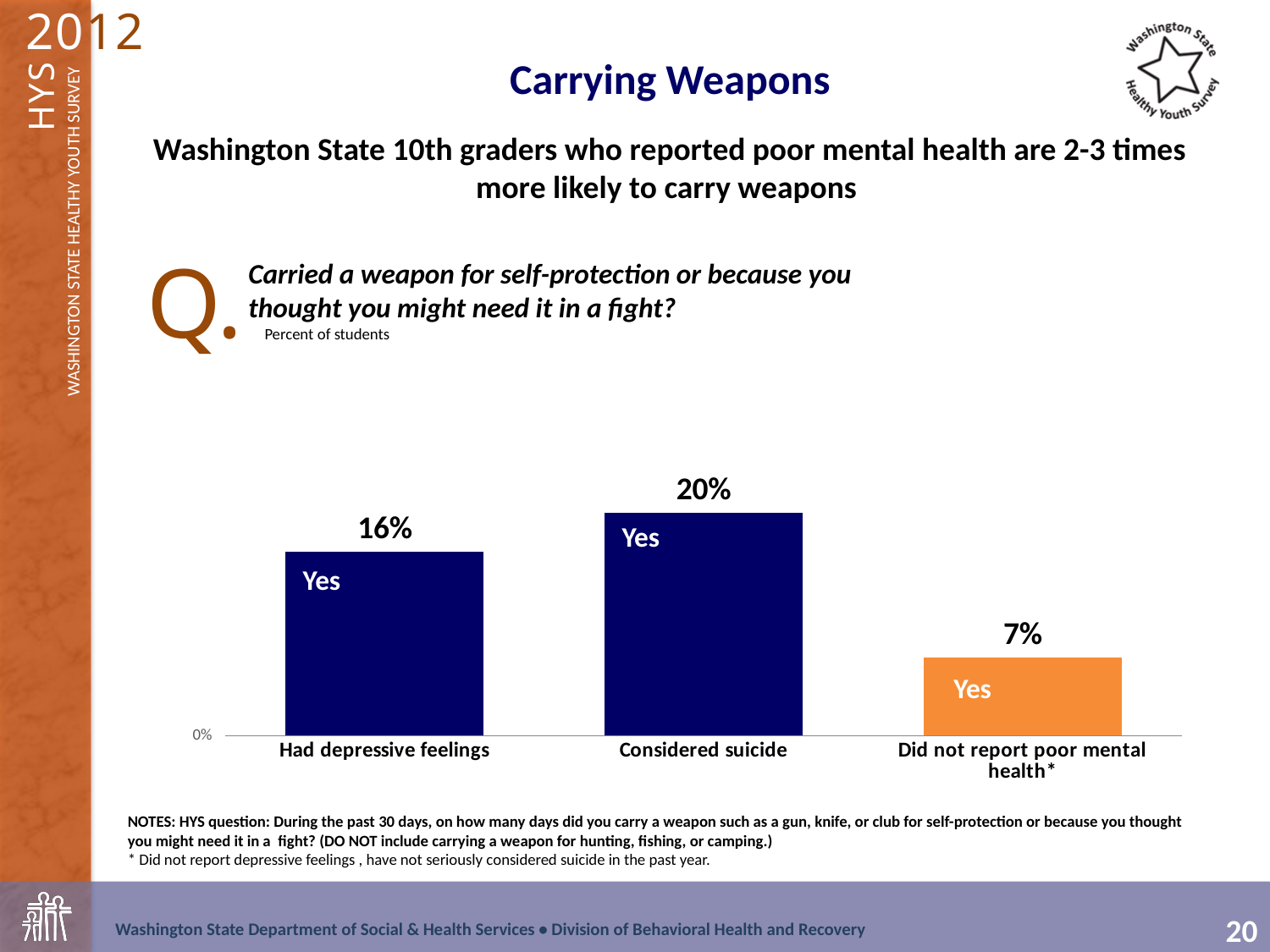
What percentage of students who did not report poor mental health reported carrying a weapon? 7% What label is printed inside each bar of the chart? Yes What percentage of students who considered suicide reported carrying a weapon? 20% How many categories are shown on the x axis of the chart? 3 Which bar in the chart is orange rather than dark blue? Did not report poor mental health* What is the difference in percentage points between the 'Had depressive feelings' and 'Did not report poor mental health*' bars? 9 Which category has the lowest percentage of students carrying a weapon? Did not report poor mental health* Which is larger: the value for 'Had depressive feelings' or the value for 'Did not report poor mental health*'? Had depressive feelings Which category has the highest percentage of students carrying a weapon? Considered suicide What percentage of students who had depressive feelings reported carrying a weapon? 16% What kind of chart is shown on the slide? Bar chart What is the difference in percentage points between the 'Considered suicide' and 'Had depressive feelings' bars? 4